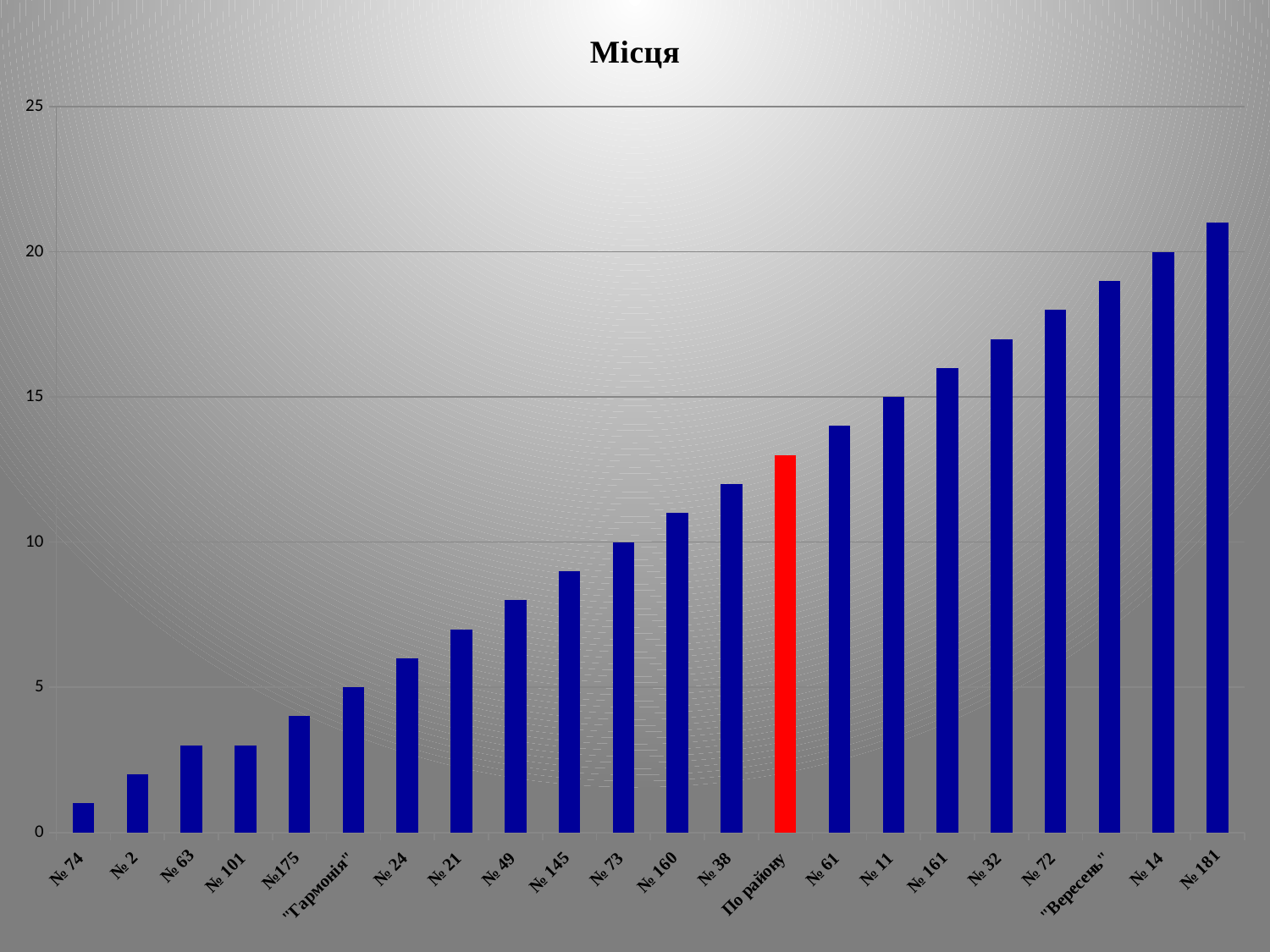
Do the bar values rise or fall from left to right along the x axis? rise Which category is shown with a red bar instead of a blue one? По району What is the value for № 14? 20 Which is larger, the value for № 32 or the value for № 61? № 32 Which category has the highest bar? № 181 What is the title of the chart? Місця What is the value for № 73? 10 What kind of chart is shown on the slide? bar chart Which category has the lowest bar? № 74 How many categories are plotted along the x axis? 22 Is the value for По району greater or less than 15? less What is the value for "Гармонія"? 5